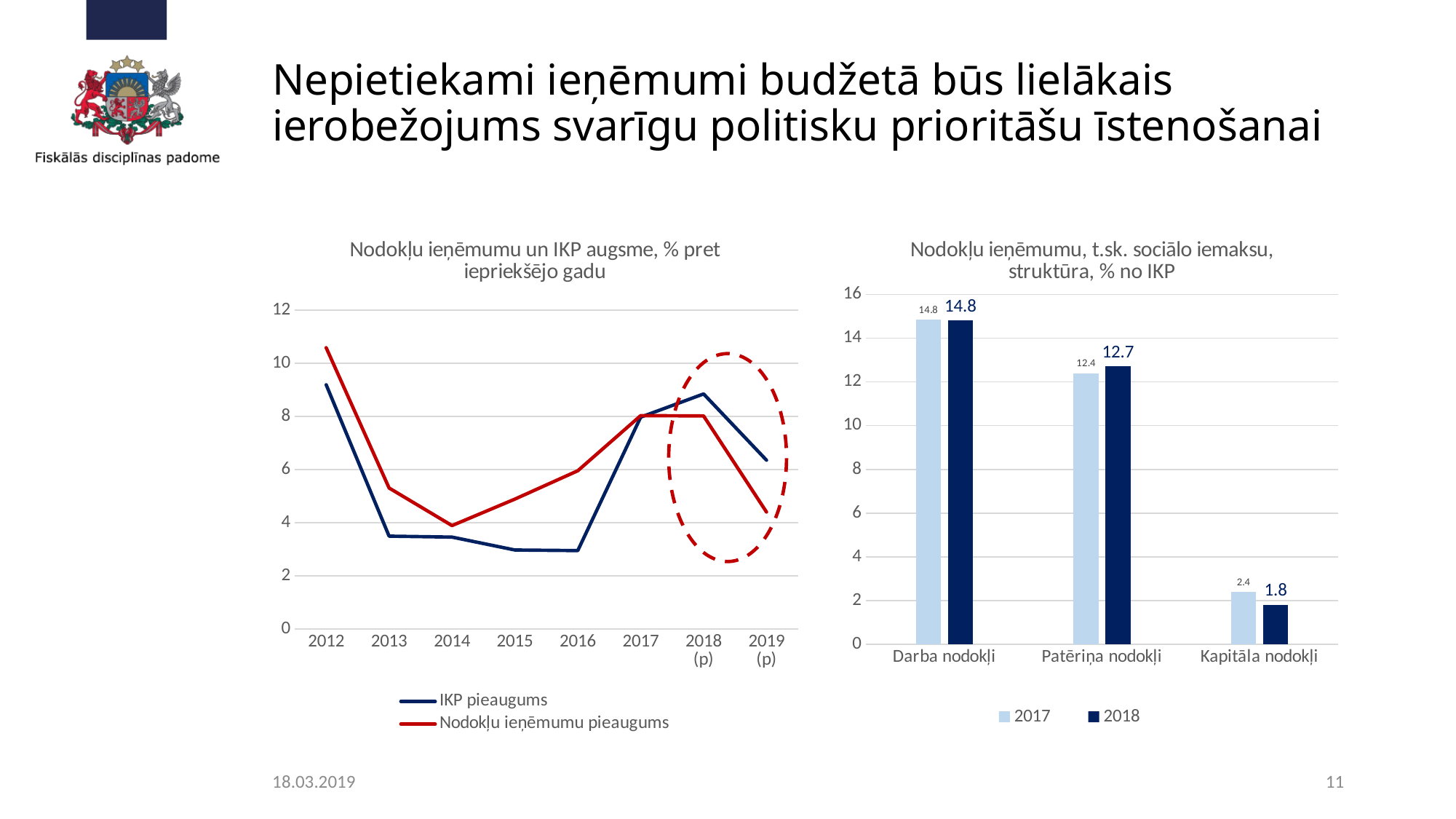
In the right chart (Nodokļu ieņēmumu struktūra, % no IKP), what is the value for Patēriņa nodokļi in 2018? 12.7 In the left chart (Nodokļu ieņēmumu un IKP augsme), how many series does the legend list? 2 In the right chart (Nodokļu ieņēmumu struktūra, % no IKP), what is the value for Kapitāla nodokļi in 2017? 2.4 In the left chart (Nodokļu ieņēmumu un IKP augsme), does the IKP pieaugums line rise or fall from 2012 to 2015? fall In the right chart (Nodokļu ieņēmumu struktūra, % no IKP), how many categories are shown on the x axis? 3 In the left chart (Nodokļu ieņēmumu un IKP augsme), is the value for IKP pieaugums in 2015 greater or less than 4? less In the left chart (Nodokļu ieņēmumu un IKP augsme), what kind of chart is it? line chart In the left chart (Nodokļu ieņēmumu un IKP augsme), how many years are shown on the x axis? 8 In the right chart (Nodokļu ieņēmumu struktūra, % no IKP), what is the difference between the 2017 and 2018 values for Kapitāla nodokļi? 0.6 In the left chart (Nodokļu ieņēmumu un IKP augsme), is the value for IKP pieaugums in 2012 greater or less than 8? greater In the right chart (Nodokļu ieņēmumu struktūra, % no IKP), which category has the lowest values? Kapitāla nodokļi In the left chart (Nodokļu ieņēmumu un IKP augsme), which series has the higher value in 2012, IKP pieaugums or Nodokļu ieņēmumu pieaugums? Nodokļu ieņēmumu pieaugums